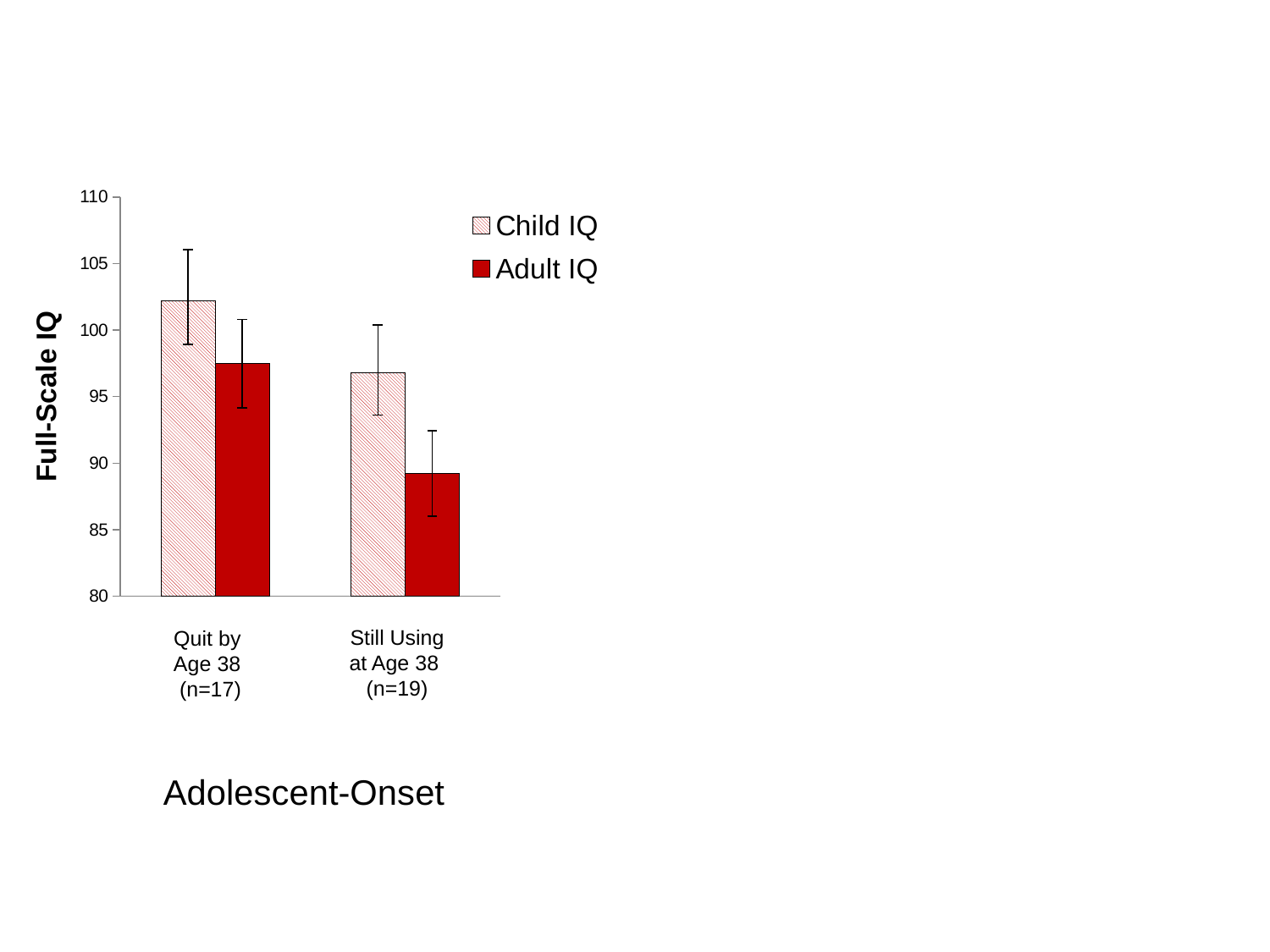
Which bar is the lowest on the chart? Adult IQ for Still Using at Age 38 (n=19) How many categories are shown on the x axis? 2 For the Still Using at Age 38 (n=19) group, which is larger, Child IQ or Adult IQ? Child IQ Does the Child IQ value rise or fall from Quit by Age 38 to Still Using at Age 38? fall Is the Adult IQ value for Still Using at Age 38 (n=19) greater or less than 95? less What kind of chart is shown on the slide? bar chart How many series does the legend list? 2 Which group has the larger Adult IQ value, Quit by Age 38 (n=17) or Still Using at Age 38 (n=19)? Quit by Age 38 (n=17) What is the title of the y axis? Full-Scale IQ Is the Child IQ value for Quit by Age 38 (n=17) greater or less than 100? greater Which bar is the highest on the chart? Child IQ for Quit by Age 38 (n=17) Is the Child IQ value for Still Using at Age 38 (n=19) greater or less than 100? less